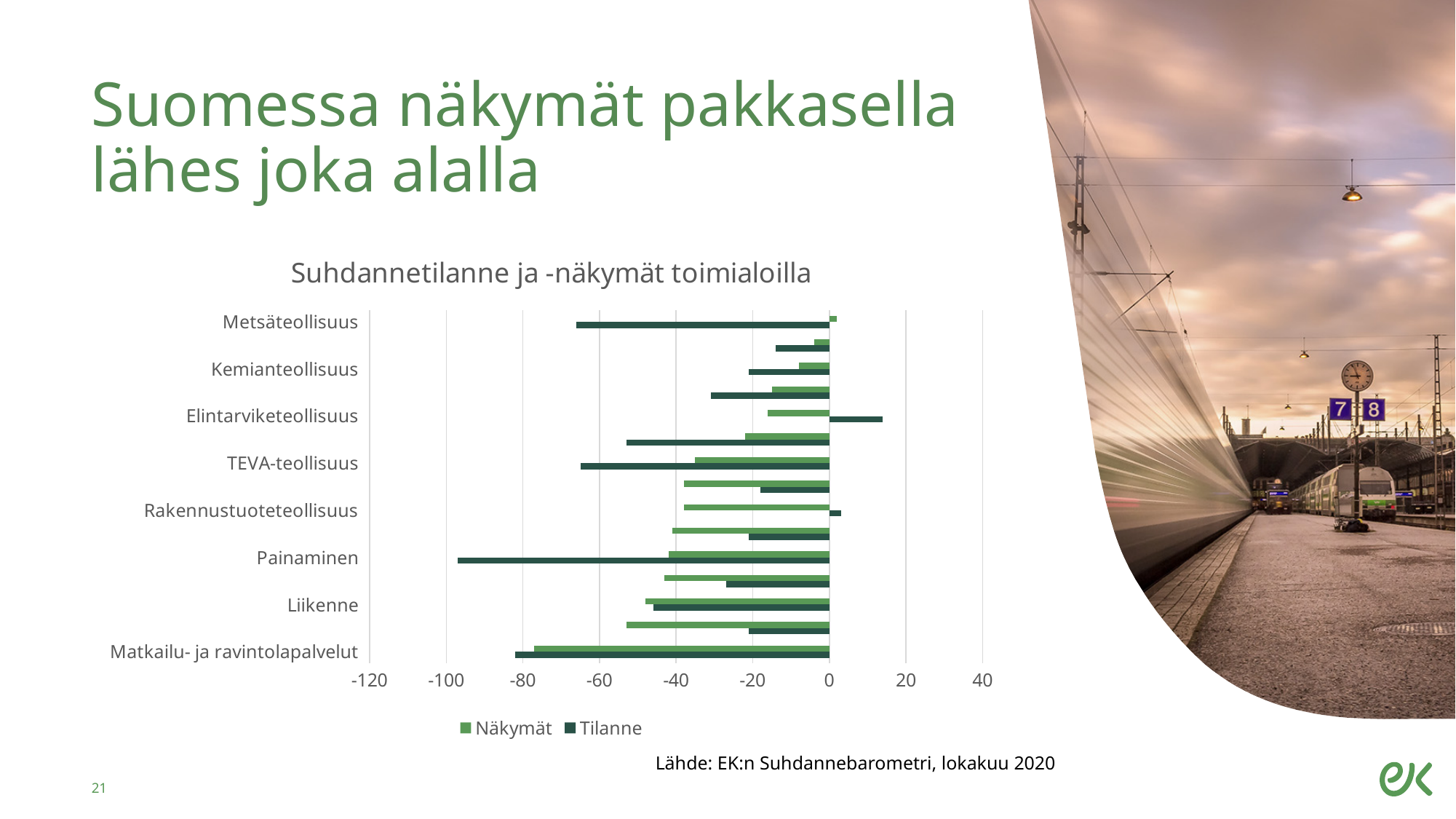
What are the two series named in the chart legend? Näkymät and Tilanne What is the title of the chart? Suhdannetilanne ja -näkymät toimialoilla Is the Tilanne value for Elintarviketeollisuus greater or less than 0? greater How many series does the chart legend list? 2 Is the Tilanne value for Metsäteollisuus greater or less than -60? less Is the Tilanne value for Painaminen greater or less than -80? less Which labelled industry has the lowest Tilanne value? Painaminen Which labelled industry has the highest Tilanne value? Elintarviketeollisuus What kind of chart is shown on the slide? Bar chart Which has the lower Näkymät value, Liikenne or Matkailu- ja ravintolapalvelut? Matkailu- ja ravintolapalvelut